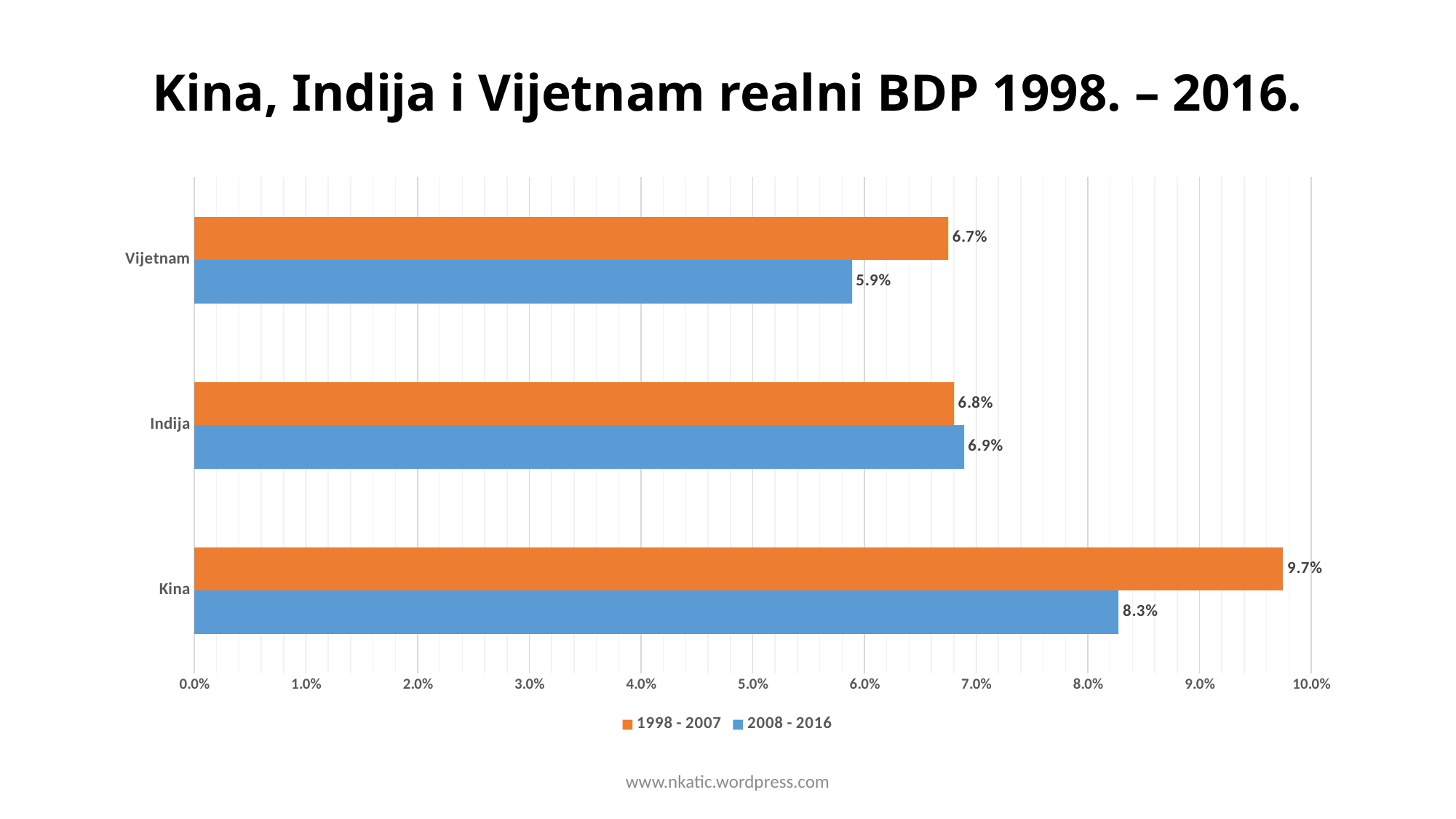
Is the 2008 - 2016 value for Kina greater or less than 8.0%? greater What is the value for Indija in the 2008 - 2016 series? 6.9% Which is larger for Vijetnam: the 1998 - 2007 value or the 2008 - 2016 value? 1998 - 2007 How many countries are shown on the chart? 3 What is the value for Vijetnam in the 2008 - 2016 series? 5.9% What kind of chart is shown on the slide? bar chart What is the difference between the 1998 - 2007 and 2008 - 2016 values for Kina? 1.4% How many series does the legend list? 2 Which country has the lowest value in the 1998 - 2007 series? Vijetnam What is the title of the chart? Kina, Indija i Vijetnam realni BDP 1998. – 2016. What is the value for Kina in the 1998 - 2007 series? 9.7% Which country has the highest value in the 2008 - 2016 series? Kina